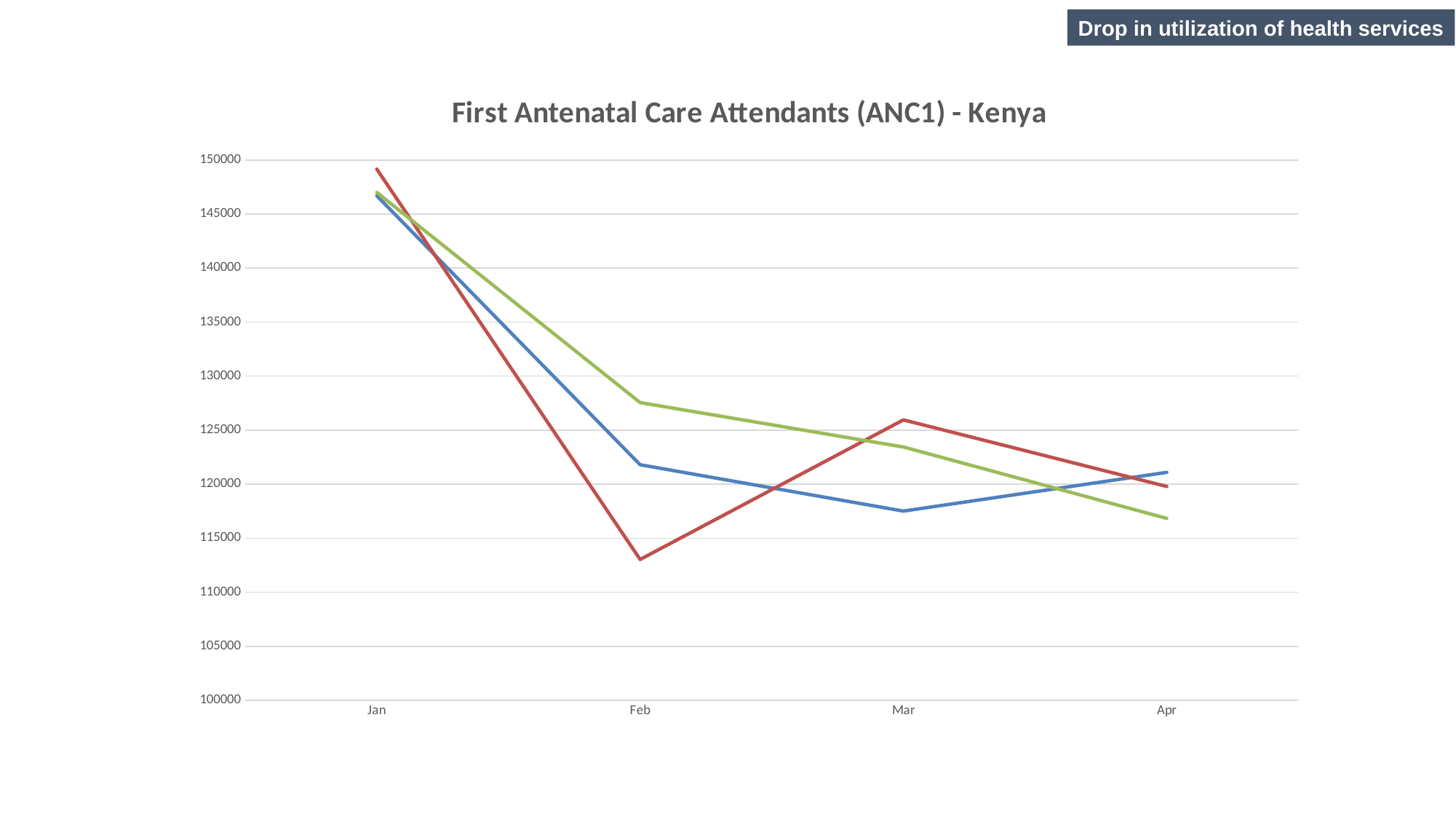
In Mar, which line has the higher value, the red line or the blue line? red line How many lines are plotted on the chart? 3 Does the red line rise or fall from Feb to Mar? rise Does the green line rise or fall from Jan to Apr? fall In Feb, which line has the higher value, the green line or the red line? green line How many months are shown on the x axis of the chart? 4 Is the value of the green line in Feb greater or less than 125000? greater Is the value of the red line in Feb greater or less than 115000? less Is the value of the green line in Apr greater or less than 120000? less What kind of chart is shown on the slide? line chart What is the title of the chart? First Antenatal Care Attendants (ANC1) - Kenya